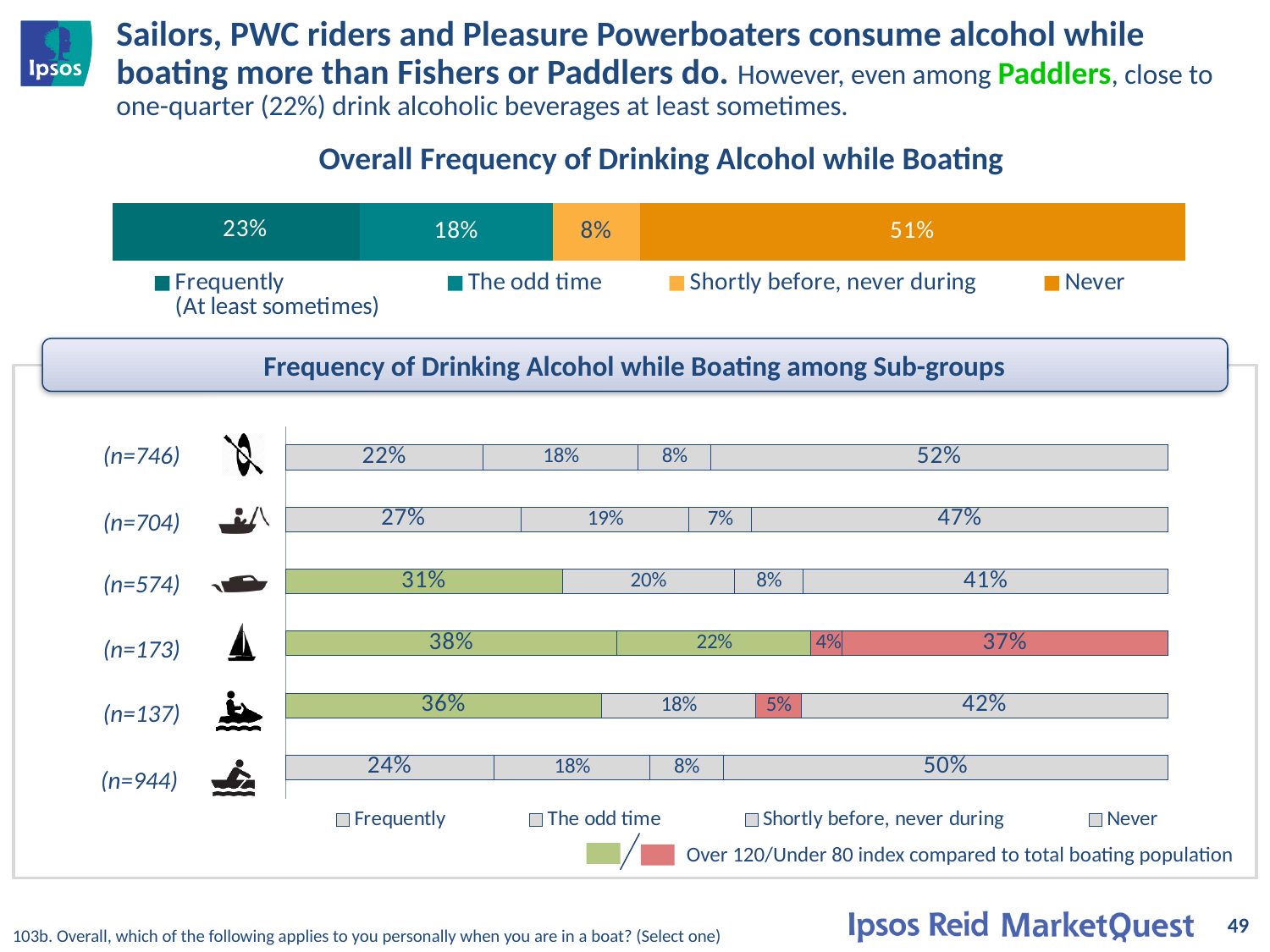
In the 'Overall Frequency of Drinking Alcohol while Boating' chart, which segment is the largest? Never In the 'Frequency of Drinking Alcohol while Boating among Sub-groups' chart, is the 'Frequently' value for the (n=137) row larger or smaller than that for the (n=574) row? larger In the 'Overall Frequency of Drinking Alcohol while Boating' chart, what percentage is shown for 'Never'? 51% What type of chart is the 'Frequency of Drinking Alcohol while Boating among Sub-groups' chart? Stacked bar chart In the 'Overall Frequency of Drinking Alcohol while Boating' chart, what is the difference between the 'Never' and 'Frequently' percentages? 28% In the 'Frequency of Drinking Alcohol while Boating among Sub-groups' chart, which row has the highest 'Frequently' value? (n=173) In the 'Frequency of Drinking Alcohol while Boating among Sub-groups' chart, how many sub-group rows are plotted? 6 In the 'Frequency of Drinking Alcohol while Boating among Sub-groups' chart, what is the 'Never' value for the (n=746) row? 52% In the 'Overall Frequency of Drinking Alcohol while Boating' chart, what percentage is shown for 'Frequently (At least sometimes)'? 23% In the 'Frequency of Drinking Alcohol while Boating among Sub-groups' chart, what is the 'Frequently' value for the (n=173) row? 38% In the 'Overall Frequency of Drinking Alcohol while Boating' chart, how many series does the legend list? 4 In the 'Frequency of Drinking Alcohol while Boating among Sub-groups' chart, which row has the lowest 'Never' value? (n=173)